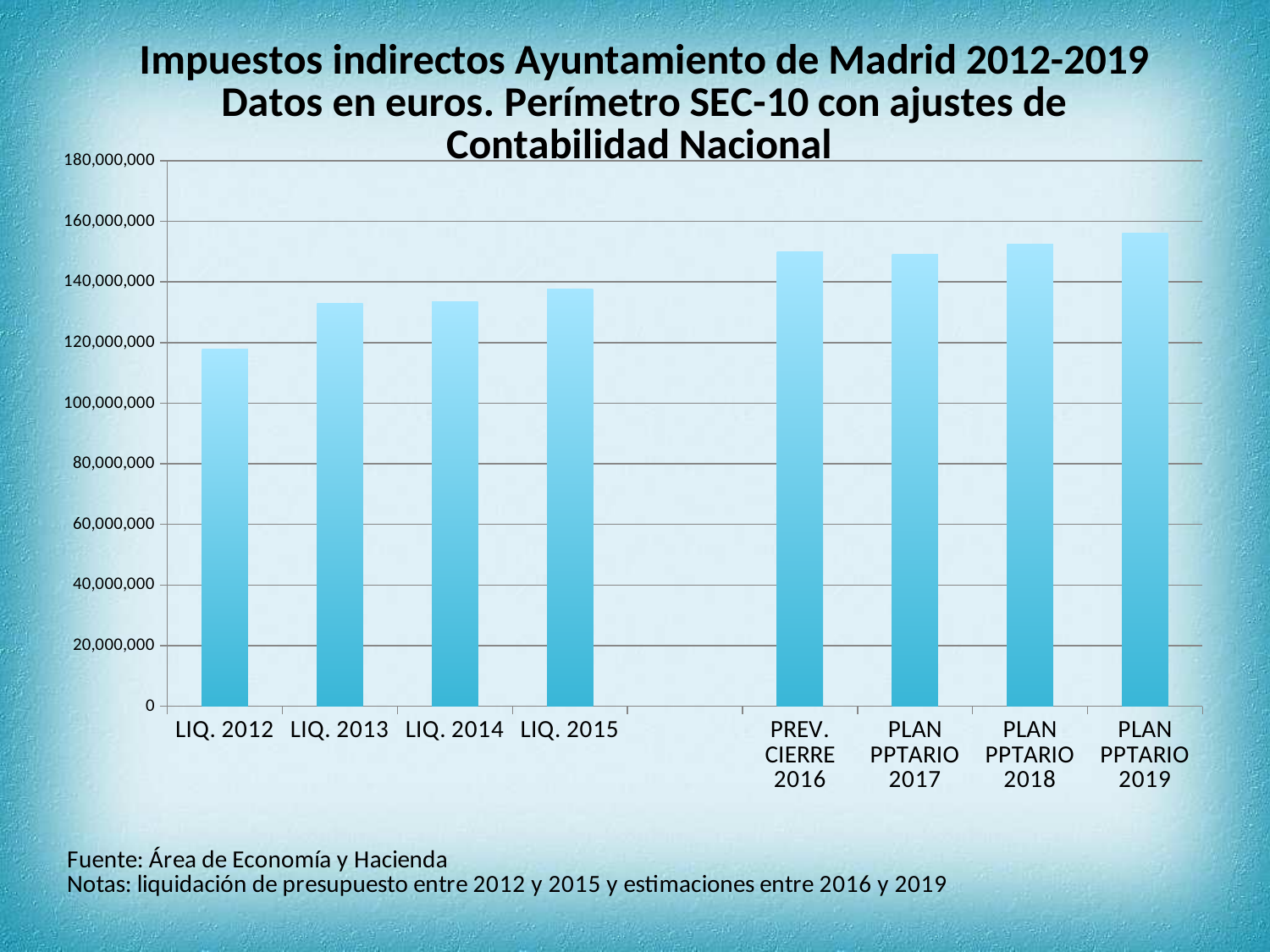
What source is cited below the chart? Área de Economía y Hacienda Which category has the lowest value? LIQ. 2012 Is the value for PLAN PPTARIO 2019 greater or less than 160,000,000? less Is the value for PREV. CIERRE 2016 greater or less than 140,000,000? greater Is the value for LIQ. 2013 greater or less than 120,000,000? greater What kind of chart is shown on the slide? bar chart Which category has the highest value? PLAN PPTARIO 2019 Which is larger, the value for LIQ. 2012 or the value for LIQ. 2013? LIQ. 2013 How many bars are plotted in the chart? 8 Which is larger, the value for LIQ. 2015 or the value for PREV. CIERRE 2016? PREV. CIERRE 2016 Do the values generally rise or fall from LIQ. 2012 to PLAN PPTARIO 2019? rise